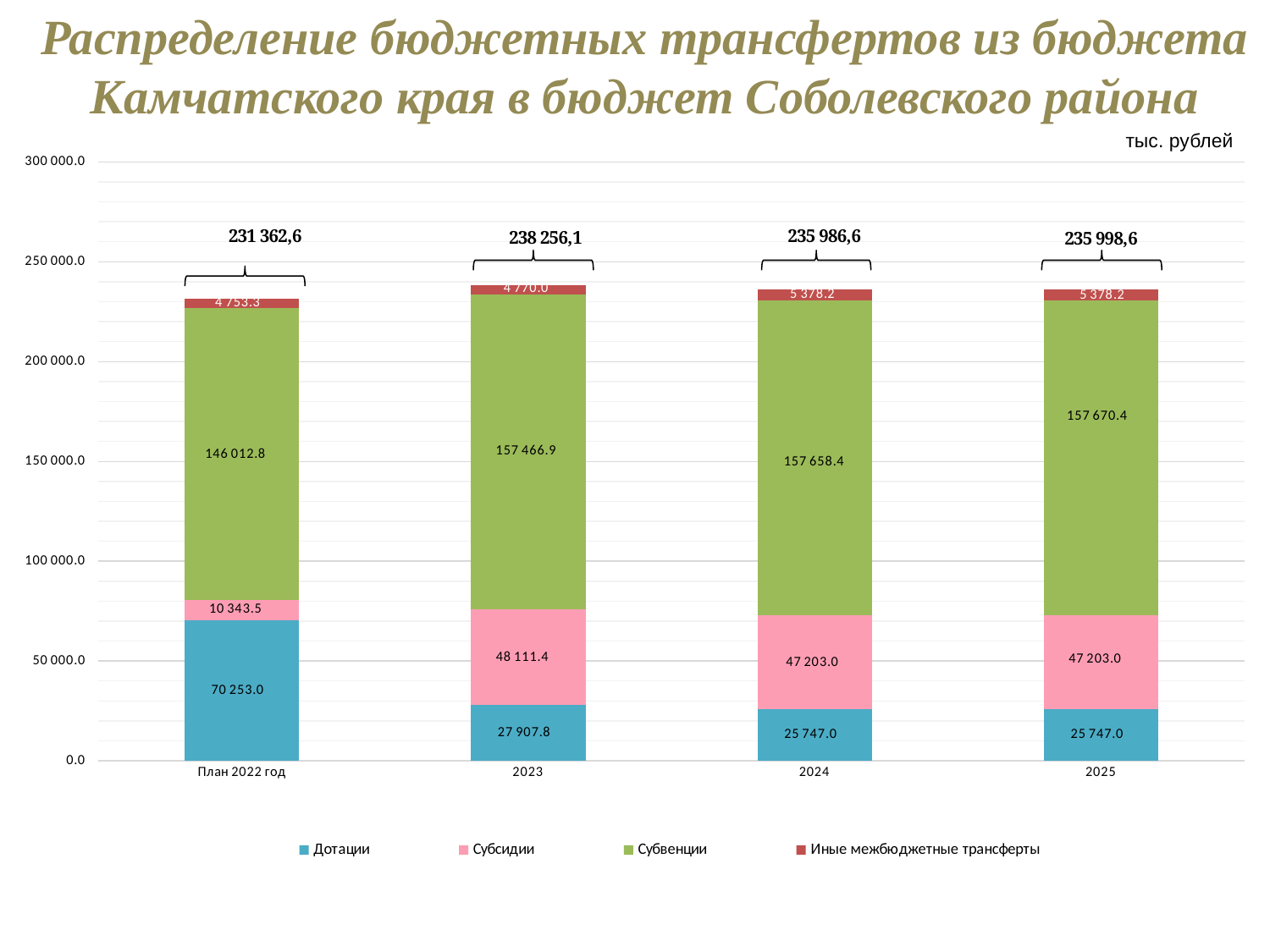
What is the value of Иные межбюджетные трансферты for 2025? 5 378.2 What kind of chart is shown on the slide? Stacked bar chart How many series does the legend list? 4 Which is larger: Субсидии for 2023 or Субсидии for 2024? 2023 Which category has the lowest value for Субсидии? План 2022 год Which category has the highest value for Дотации? План 2022 год What is the value of Субсидии for 2023? 48 111.4 What is the value of Дотации for План 2022 год? 70 253.0 What is the value of Субвенции for 2024? 157 658.4 What is the difference between the Дотации values for План 2022 год and 2023? 42 345.2 What is the total of the stacked bar for 2023? 238 256,1 How many categories are shown on the x axis? 4